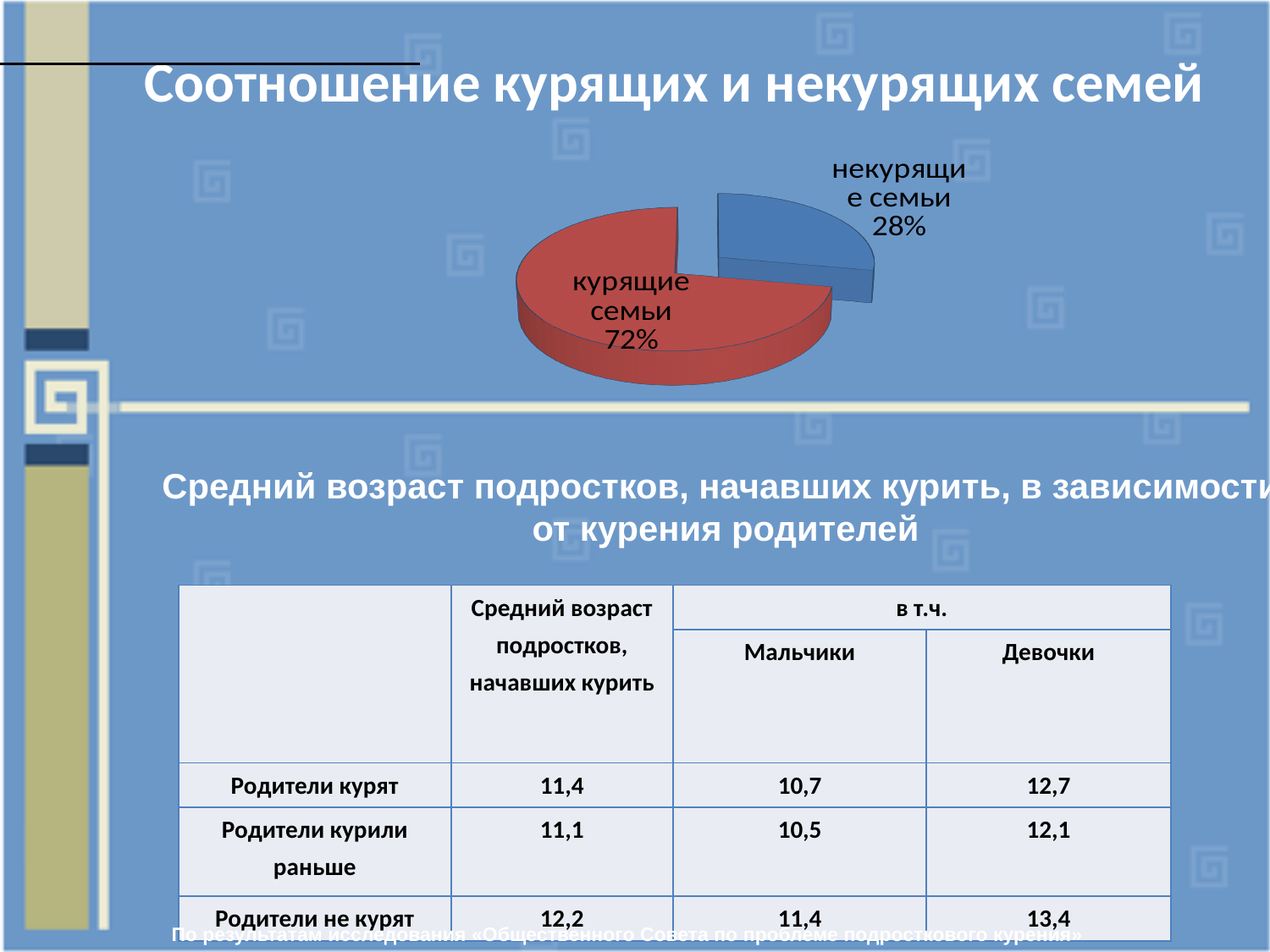
What colour is the "курящие семьи" slice of the pie chart? red What kind of chart is shown on the slide? pie chart What share of the pie does "курящие семьи" take? 72% What is the difference in percentage points between "курящие семьи" and "некурящие семьи"? 44 What is the title of the pie chart on the slide? Соотношение курящих и некурящих семей Which slice of the pie chart is the largest? курящие семьи Which slice of the pie chart is the smallest? некурящие семьи Which is larger: the share of "курящие семьи" or the share of "некурящие семьи"? курящие семьи What share of the pie does "некурящие семьи" take? 28% How many slices does the pie chart have? 2